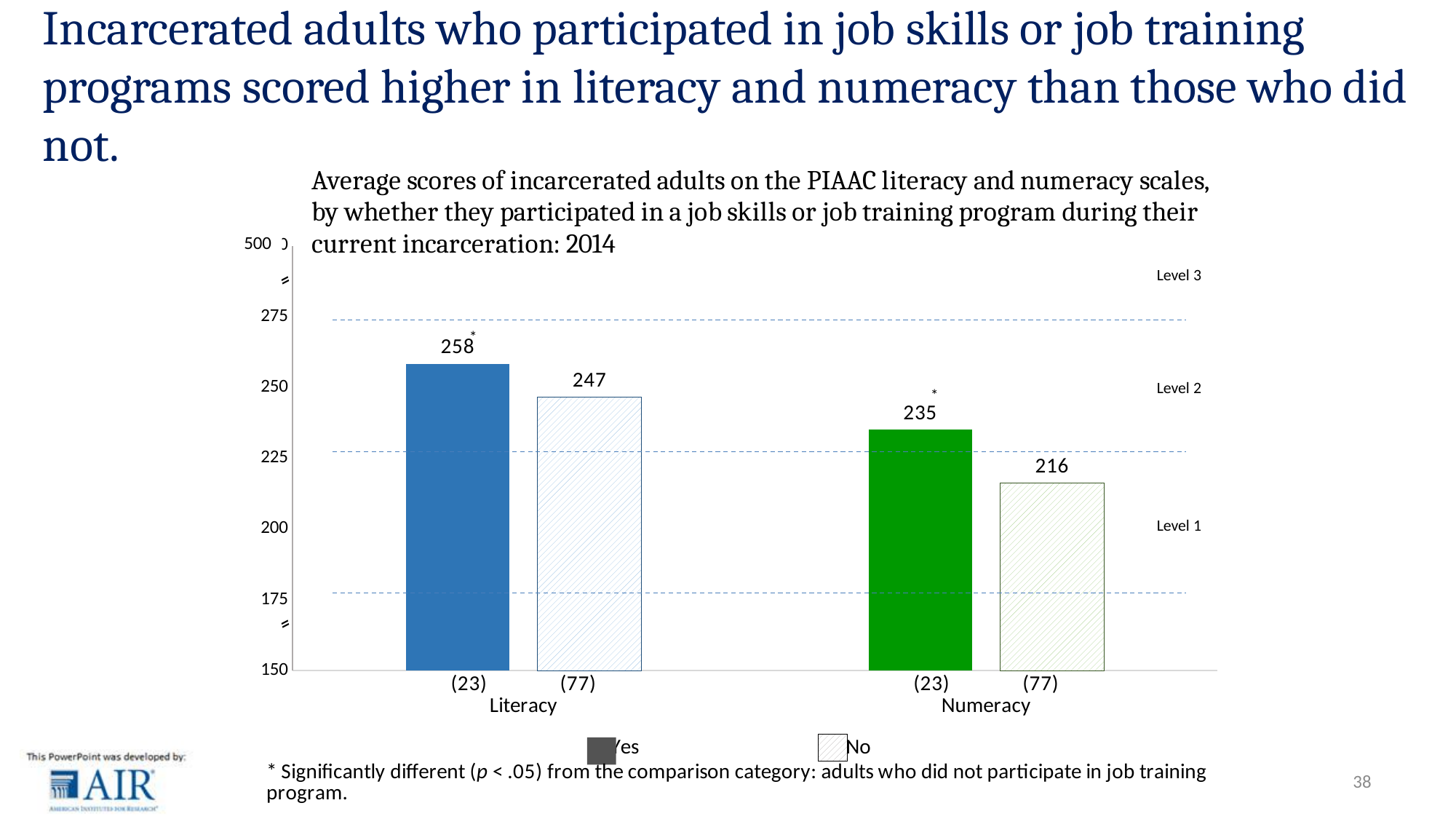
What is the average literacy score for incarcerated adults who participated in a job skills or job training program (Yes)? 258 What is the difference between the numeracy scores of the Yes and No groups? 19 What is the average numeracy score for the Yes group? 235 What is the difference between the literacy scores of the Yes and No groups? 11 How many series does the legend list? 2 What is the average literacy score for the No group? 247 What percentage of incarcerated adults, shown in parentheses under the bars, did not participate in a job skills or job training program? 77 What kind of chart is shown on the slide? Bar chart What is the average numeracy score for incarcerated adults who did not participate in a job skills or job training program (No)? 216 Which bar shows the lowest average score on the chart? Numeracy, No (216) Which is larger, the numeracy score for the Yes group or the literacy score for the No group? Literacy score for the No group (247) Which bar shows the highest average score on the chart? Literacy, Yes (258)